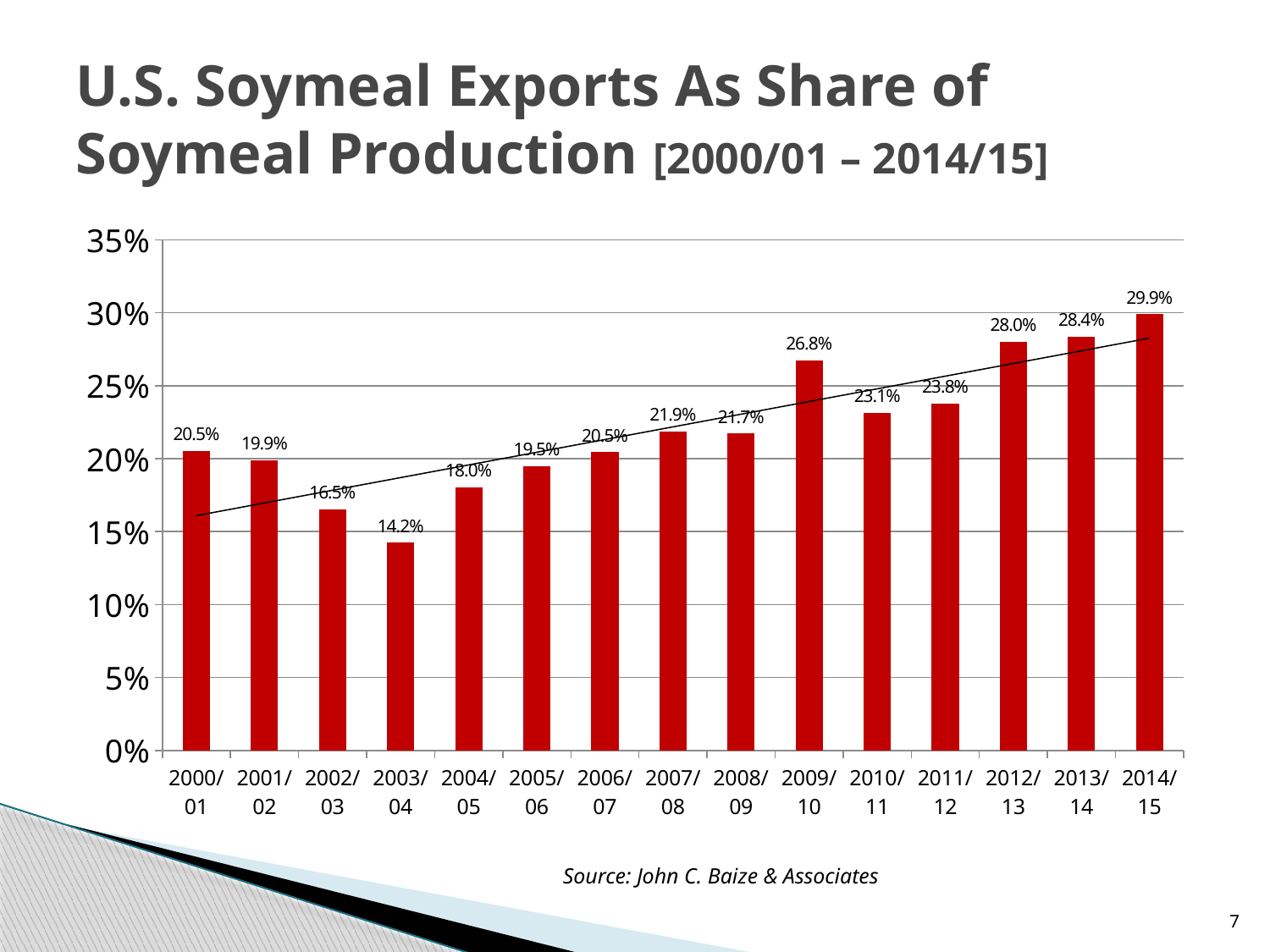
Is the value for 2012/13 greater or less than 25%? greater How many years are shown on the x axis? 15 What is the source cited below the chart? John C. Baize & Associates What kind of chart is this? bar chart What is the difference between the values for 2014/15 and 2000/01? 9.4% What is the value for 2009/10? 26.8% What is the value for 2014/15? 29.9% Which year has the lowest share? 2003/04 Which year has the highest share? 2014/15 What is the difference between the values for 2009/10 and 2010/11? 3.7% Which is larger, the value for 2007/08 or the value for 2008/09? 2007/08 What is the value for 2003/04? 14.2%